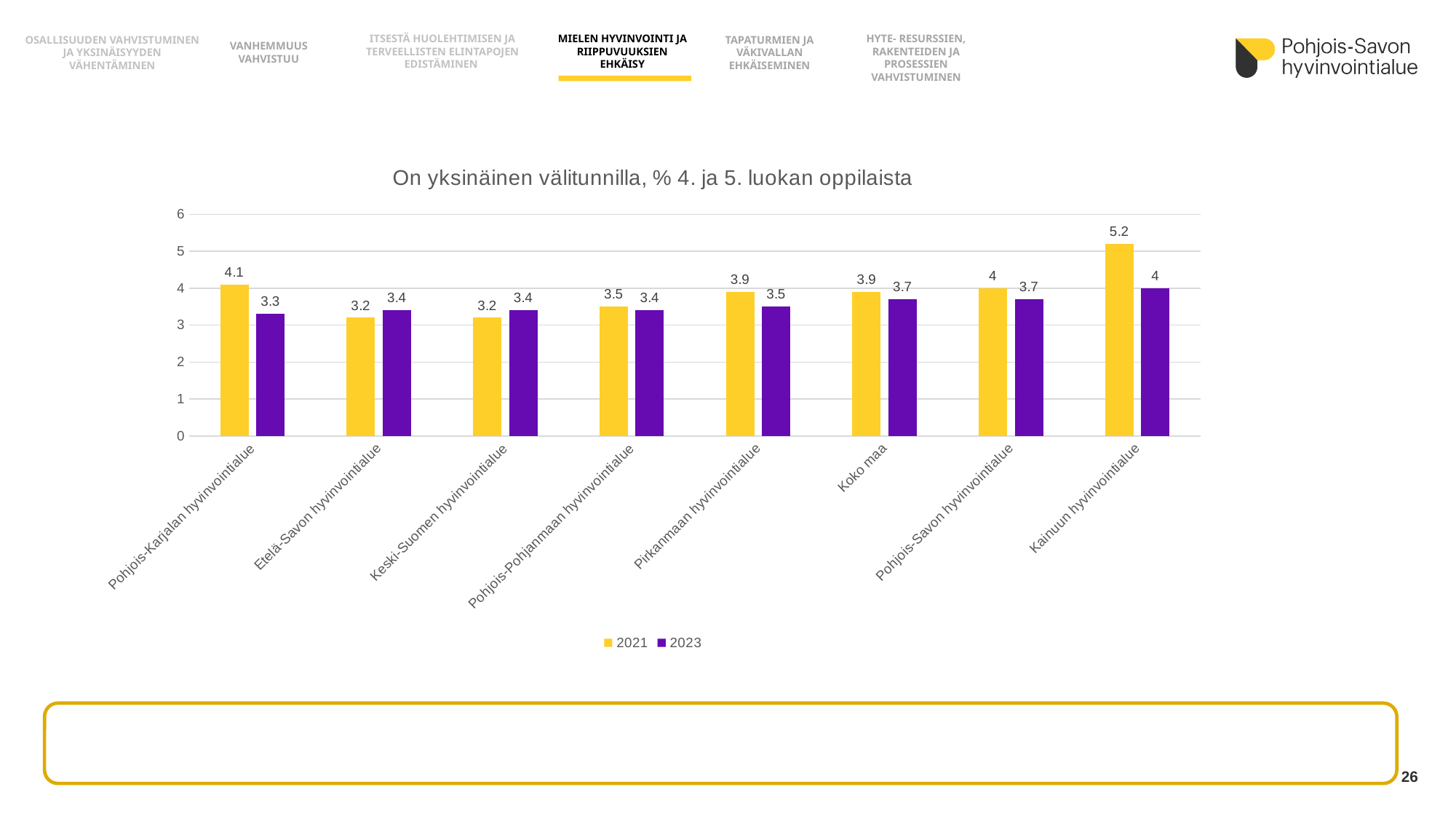
What is the 2023 value for Kainuun hyvinvointialue? 4 What kind of chart is shown on the slide? Bar chart Which category has the lowest 2023 value? Pohjois-Karjalan hyvinvointialue What is the difference between the 2021 and 2023 values for Kainuun hyvinvointialue? 1.2 What is the title of the chart? On yksinäinen välitunnilla, % 4. ja 5. luokan oppilaista What is the 2023 value for Koko maa? 3.7 Which colour represents the 2023 series? Purple How many categories are shown on the x axis? 8 What is the 2021 value for Pohjois-Karjalan hyvinvointialue? 4.1 Which is larger for Pohjois-Savon hyvinvointialue, the 2021 value or the 2023 value? 2021 Which category has the highest 2021 value? Kainuun hyvinvointialue How many series does the legend list? 2